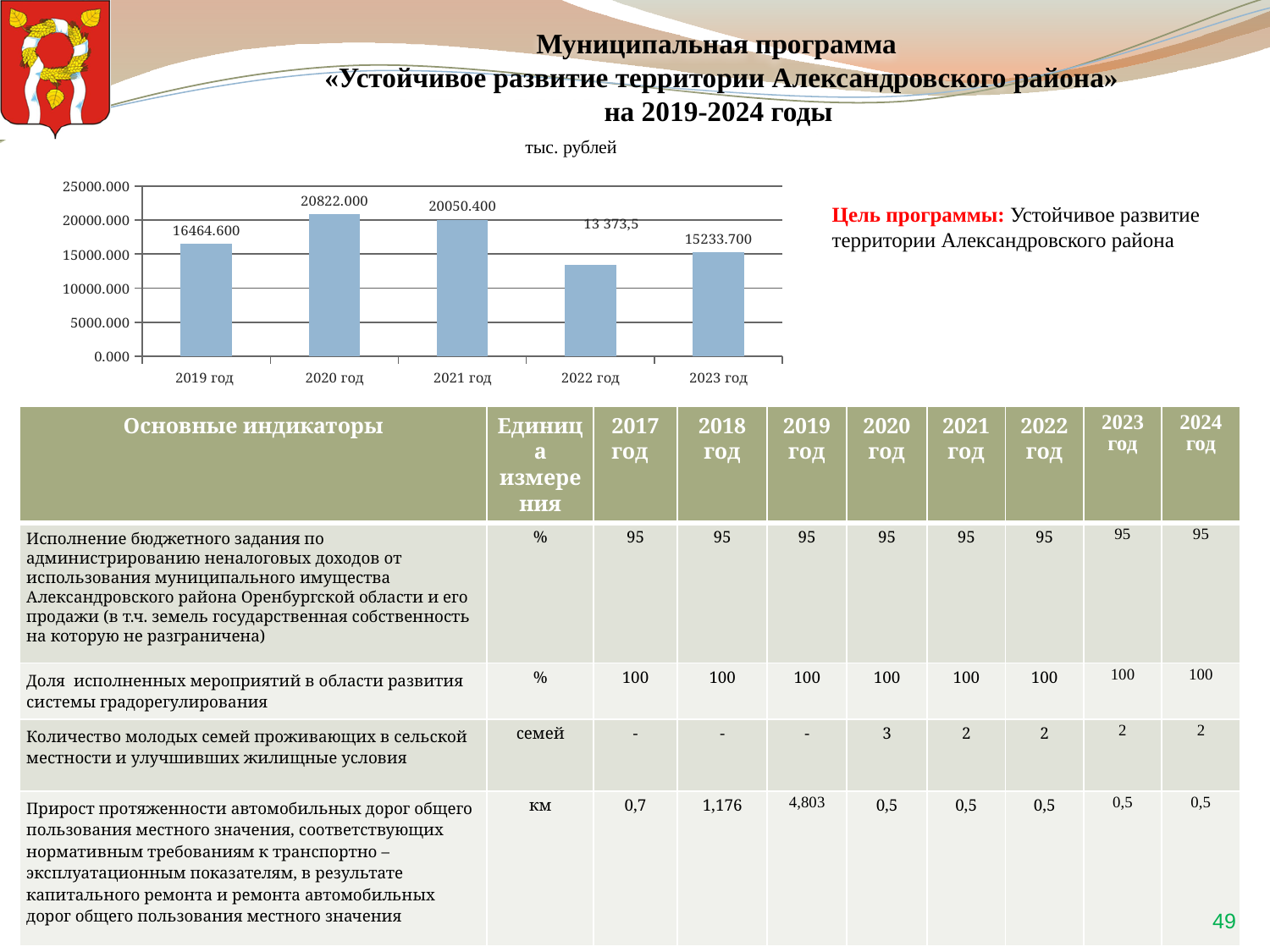
What unit of measurement is indicated above the chart? тыс. рублей What is the difference between the values for 2020 год and 2021 год? 771.600 What is the difference between the values for 2019 год and 2023 год? 1230.900 What is the value for 2022 год in the bar chart? 13 373,5 What is the value for 2023 год in the bar chart? 15233.700 What is the value for 2019 год in the bar chart? 16464.600 Which year has the lowest value in the bar chart? 2022 год How many years are shown in the bar chart? 5 Is the value for 2022 год greater or less than 15000.000? less What kind of chart is shown on the slide? bar chart Which is larger, the value for 2019 год or the value for 2023 год? 2019 год Which year has the highest value in the bar chart? 2020 год